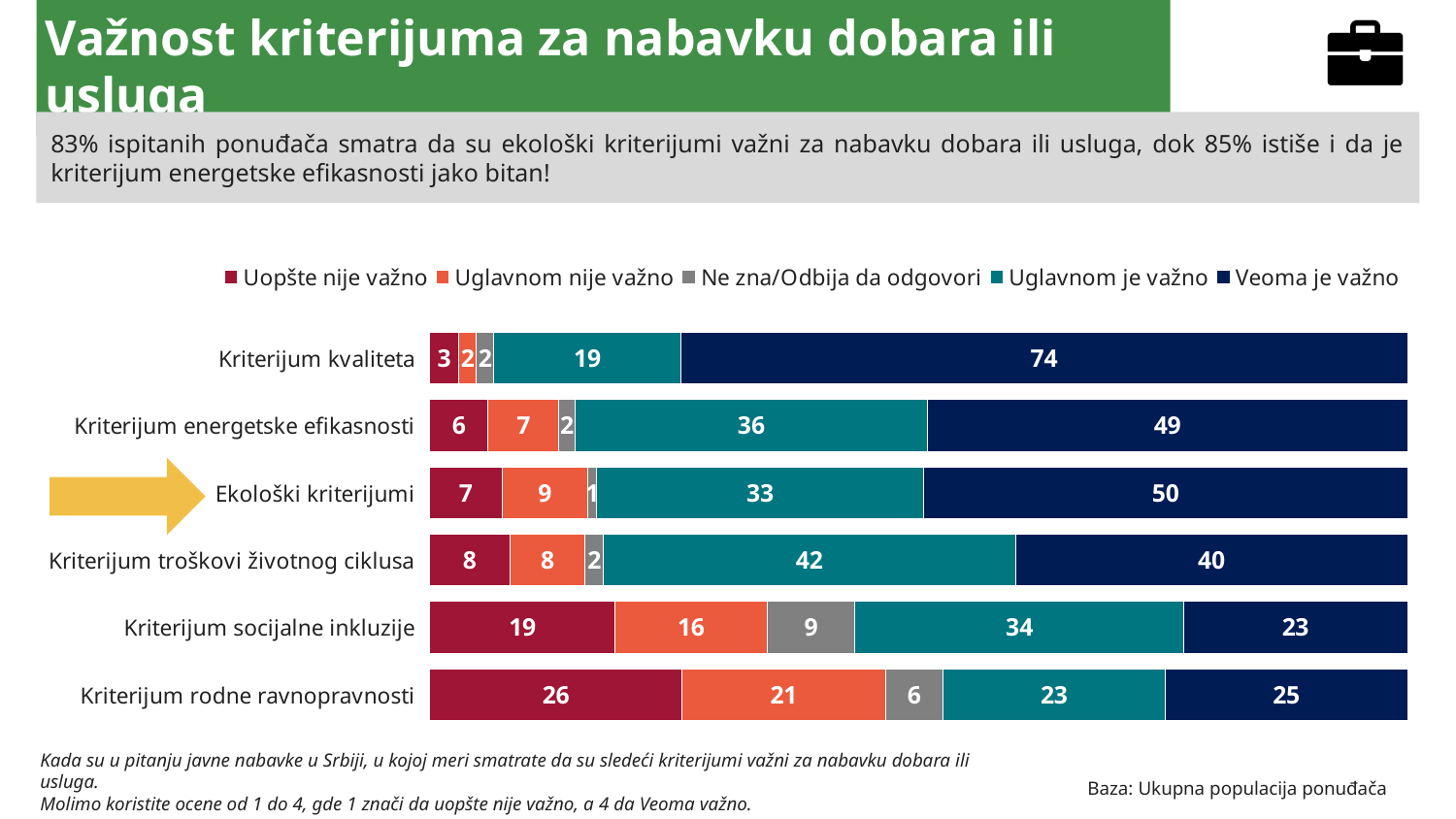
What is the 'Veoma je važno' value for Kriterijum kvaliteta? 74 How many criteria (categories) are shown in the chart? 6 How many series does the legend list? 5 What is the total of the stacked bar for Kriterijum energetske efikasnosti? 100 Which criterion has the lowest 'Uglavnom je važno' value? Kriterijum kvaliteta What is the difference between the 'Veoma je važno' values for Ekološki kriterijumi and Kriterijum socijalne inkluzije? 27 Which is larger: the 'Uglavnom nije važno' value for Kriterijum socijalne inkluzije or for Kriterijum rodne ravnopravnosti? Kriterijum rodne ravnopravnosti What is the 'Uopšte nije važno' value for Kriterijum rodne ravnopravnosti? 26 Which criterion has the highest 'Veoma je važno' value? Kriterijum kvaliteta Which legend entry is shown in grey? Ne zna/Odbija da odgovori What type of chart is shown on the slide? Stacked bar chart What is the 'Uglavnom je važno' value for Kriterijum troškovi životnog ciklusa? 42